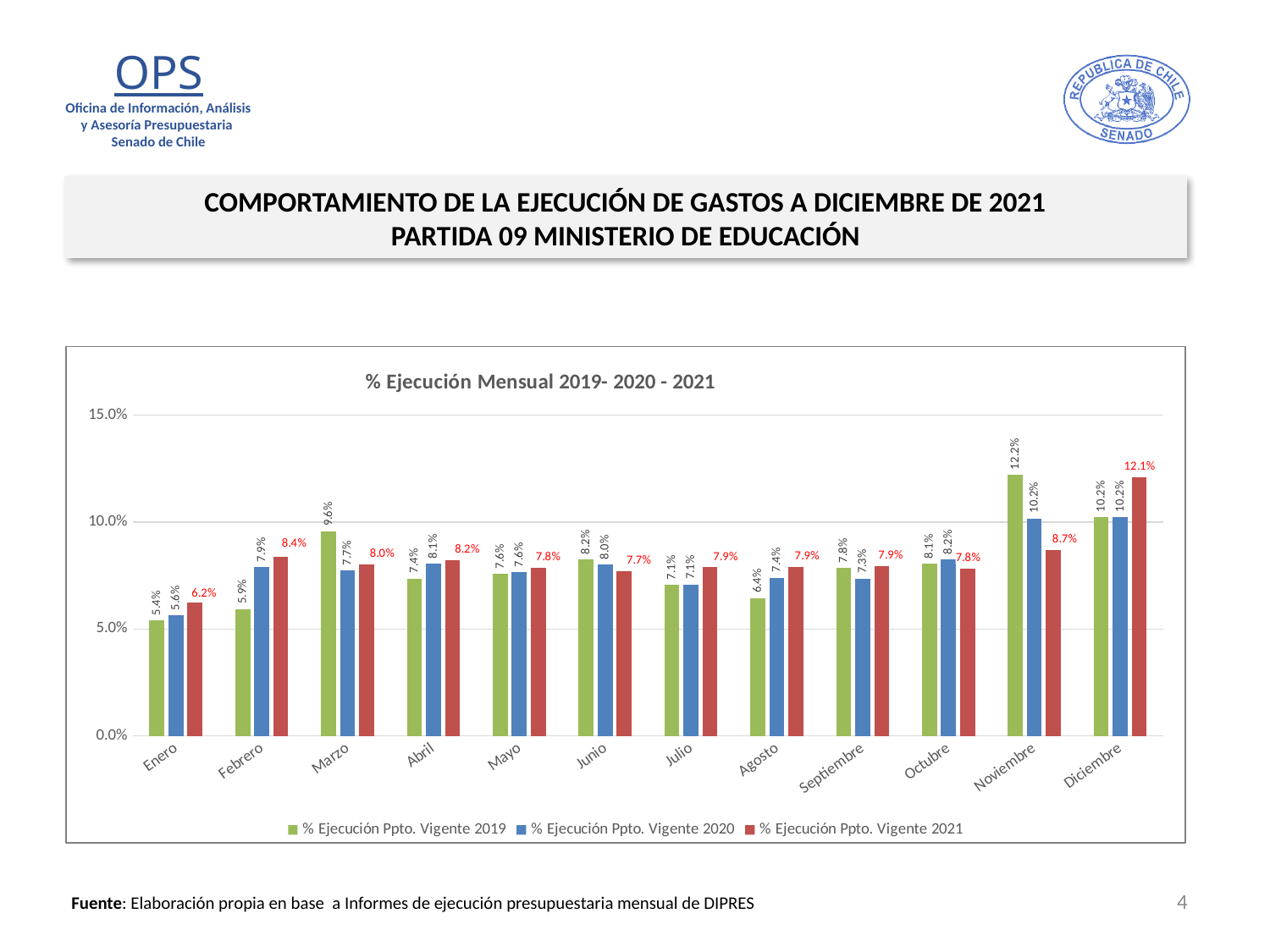
What is the value for % Ejecución Ppto. Vigente 2021 in Noviembre? 8.7% Which is larger in Febrero: the 2019 value or the 2020 value? 2020 value What kind of chart is shown on the slide? Bar chart What is the value for % Ejecución Ppto. Vigente 2020 in Agosto? 7.4% How many months are shown on the x axis? 12 Is the value for % Ejecución Ppto. Vigente 2019 in Noviembre greater or less than 10.0%? greater What is the difference between the 2019 and 2021 values in Noviembre? 3.5% How many series does the legend list? 3 Which month has the lowest value for % Ejecución Ppto. Vigente 2019? Enero What is the title of the chart? % Ejecución Mensual 2019- 2020 - 2021 Which month has the highest value for % Ejecución Ppto. Vigente 2021? Diciembre What is the value for % Ejecución Ppto. Vigente 2019 in Marzo? 9.6%